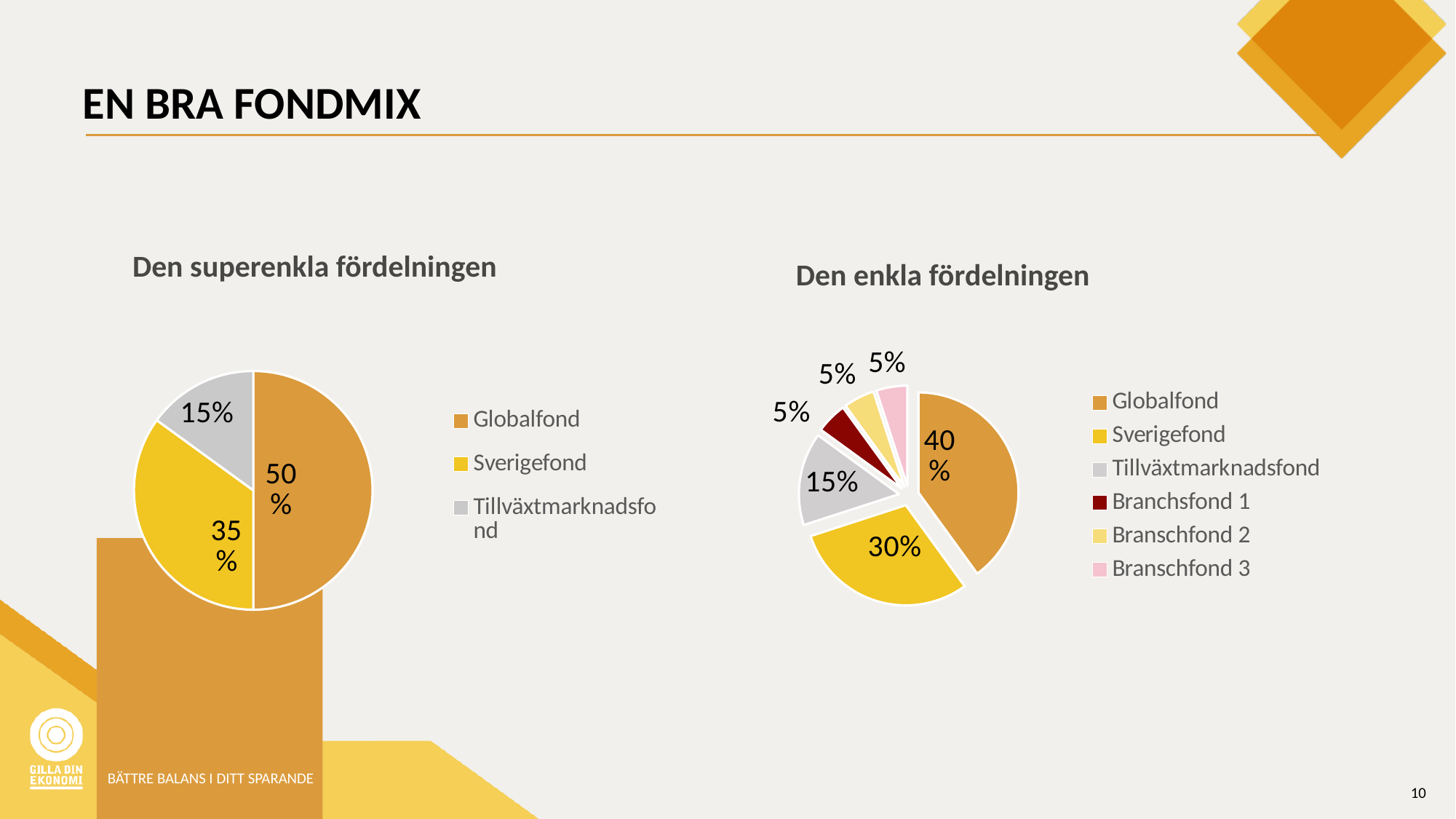
In the 'Den enkla fördelningen' chart, what share does Tillväxtmarknadsfond have? 15% In the 'Den superenkla fördelningen' chart, how many slices does the pie have? 3 In the 'Den enkla fördelningen' chart, which is larger, Sverigefond or Tillväxtmarknadsfond? Sverigefond In the 'Den superenkla fördelningen' chart, which category has the smallest slice? Tillväxtmarknadsfond In the 'Den enkla fördelningen' chart, how many categories does the legend list? 6 In the 'Den enkla fördelningen' chart, which category has the largest slice? Globalfond What type of chart is used for 'Den enkla fördelningen'? Pie chart In the 'Den superenkla fördelningen' chart, what share does Globalfond have? 50% In the 'Den enkla fördelningen' chart, what is the difference between the Globalfond and Sverigefond shares? 10% In the 'Den superenkla fördelningen' chart, what is the difference between the Globalfond and Sverigefond shares? 15% In the 'Den enkla fördelningen' chart, what share does Globalfond have? 40% In the 'Den superenkla fördelningen' chart, what share does Sverigefond have? 35%